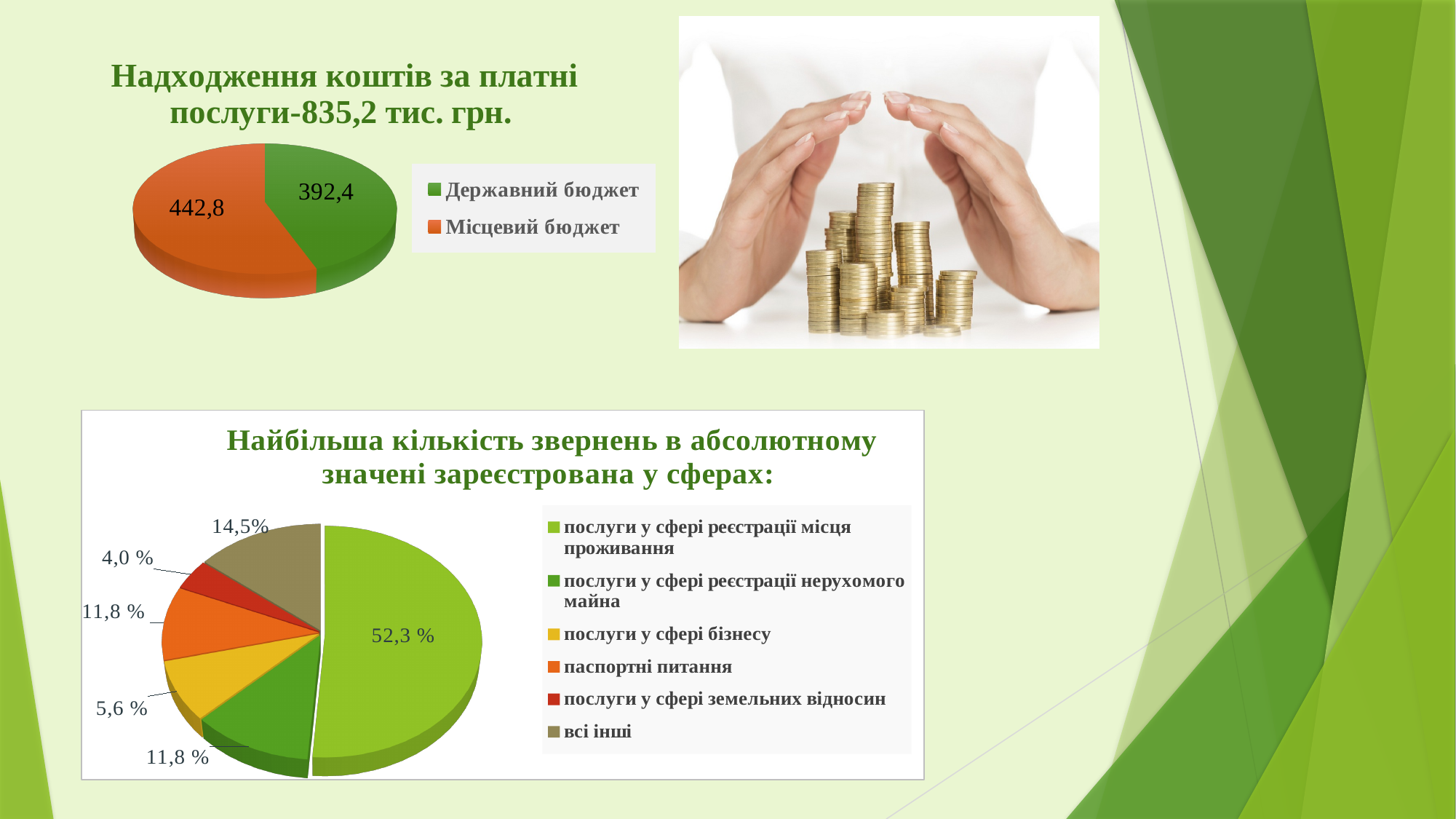
In the top pie chart 'Надходження коштів за платні послуги', what is the value for Місцевий бюджет? 442,8 What type of chart is the top chart 'Надходження коштів за платні послуги'? pie chart In the top pie chart 'Надходження коштів за платні послуги', what is the value for Державний бюджет? 392,4 In the bottom pie chart 'Найбільша кількість звернень', what share is shown for послуги у сфері бізнесу? 5,6 % In the bottom pie chart 'Найбільша кількість звернень', which category has the smallest share? послуги у сфері земельних відносин In the bottom pie chart 'Найбільша кількість звернень', which is larger: the share for паспортні питання or the share for послуги у сфері земельних відносин? паспортні питання In the top pie chart 'Надходження коштів за платні послуги', which category has the larger value? Місцевий бюджет In the bottom pie chart 'Найбільша кількість звернень', what share is shown for всі інші? 14,5% In the top pie chart 'Надходження коштів за платні послуги', what is the difference between Місцевий бюджет and Державний бюджет? 50,4 How many categories does the legend of the top pie chart 'Надходження коштів за платні послуги' list? 2 How many categories does the legend of the bottom pie chart 'Найбільша кількість звернень' list? 6 In the bottom pie chart 'Найбільша кількість звернень', what share is shown for послуги у сфері реєстрації місця проживання? 52,3 %